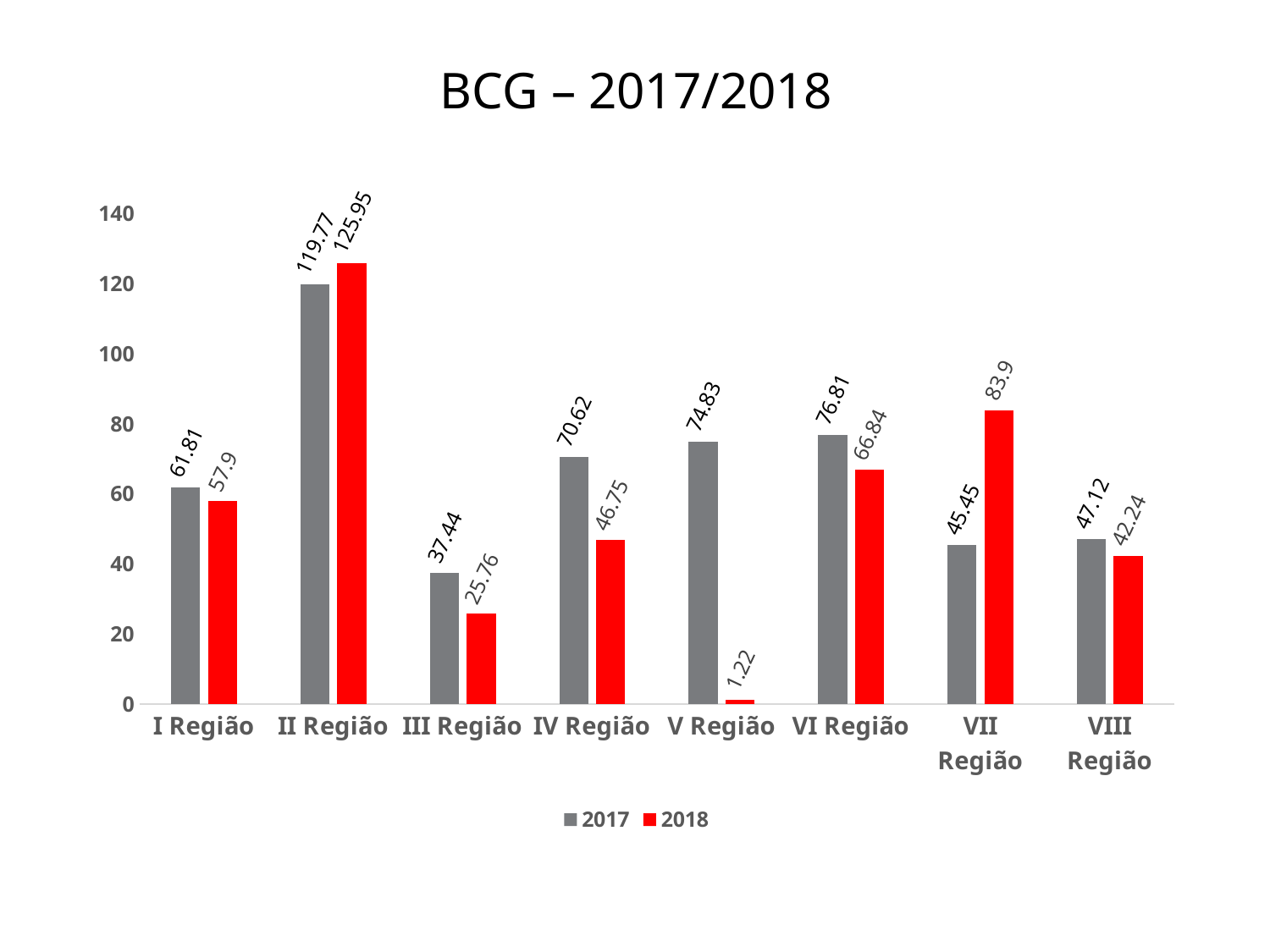
Is the 2017 value for IV Região greater or less than 60? greater What is the difference between the 2018 and 2017 values for II Região? 6.18 What kind of chart is shown? bar chart What is the title of the chart? BCG – 2017/2018 What is the 2018 value for VII Região? 83.9 Which region has the highest 2018 value? II Região What is the 2018 value for V Região? 1.22 How many series does the legend list? 2 What is the 2017 value for II Região? 119.77 How many regions are shown on the x axis? 8 Which is larger for VI Região, the 2017 value or the 2018 value? 2017 Which region has the lowest 2017 value? VII Região